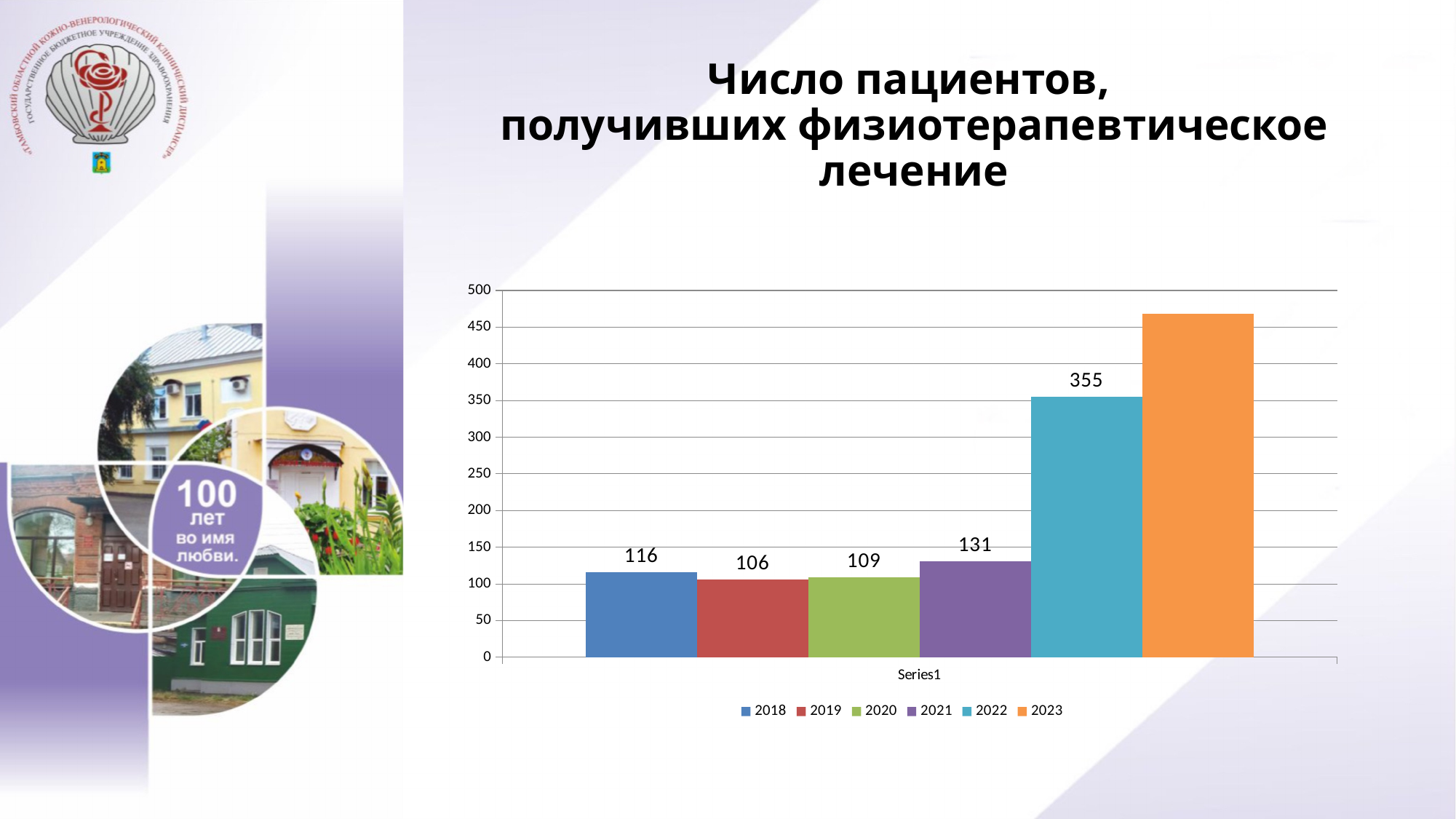
What is the value for 2021? 131 What is the title of the slide? Число пациентов, получивших физиотерапевтическое лечение What is the value for 2022? 355 How many series does the legend list? 6 Which year has the lowest value? 2019 What is the value for 2018? 116 Is the value for 2023 greater or less than 450? greater What kind of chart is shown on the slide? bar chart Which is larger, the value for 2020 or the value for 2019? 2020 What is the difference between the values for 2022 and 2021? 224 Which year has the highest value? 2023 What is the value for 2019? 106